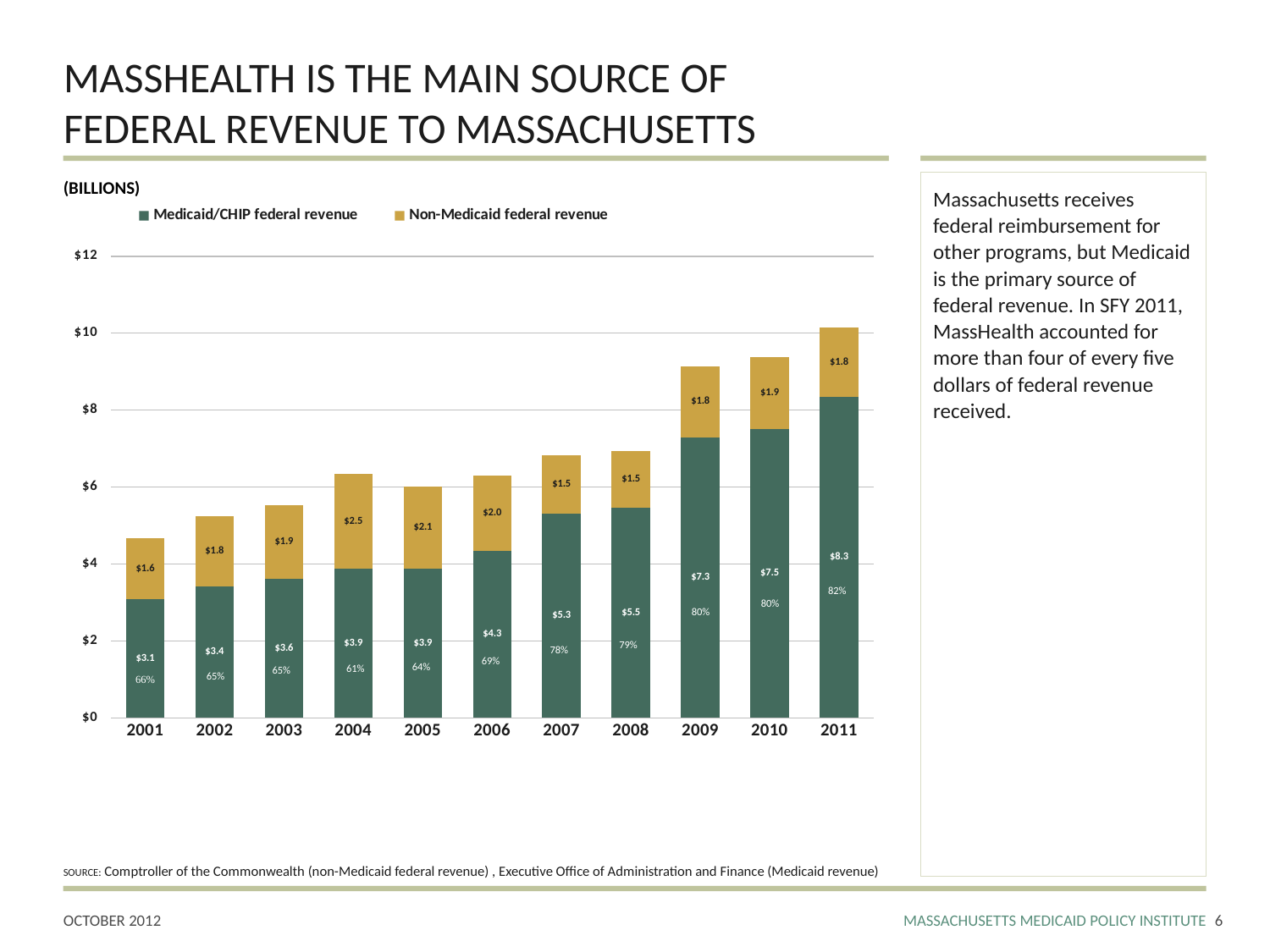
What is the Non-Medicaid federal revenue for 2004? $2.5 Which year has the lowest Medicaid/CHIP federal revenue? 2001 What is the total federal revenue (both series combined) for 2001? $4.7 What is the total federal revenue (both series combined) for 2011? $10.1 Which year has the highest Medicaid/CHIP federal revenue? 2011 What percentage of federal revenue did Medicaid/CHIP account for in 2006? 69% How many series does the legend list? 2 How many years are shown on the x axis? 11 Which is larger, the Non-Medicaid federal revenue in 2004 or in 2007? 2004 What is the Medicaid/CHIP federal revenue for 2011? $8.3 What kind of chart is shown on the slide? Stacked bar chart What is the difference between the Medicaid/CHIP federal revenue in 2011 and in 2001? $5.2